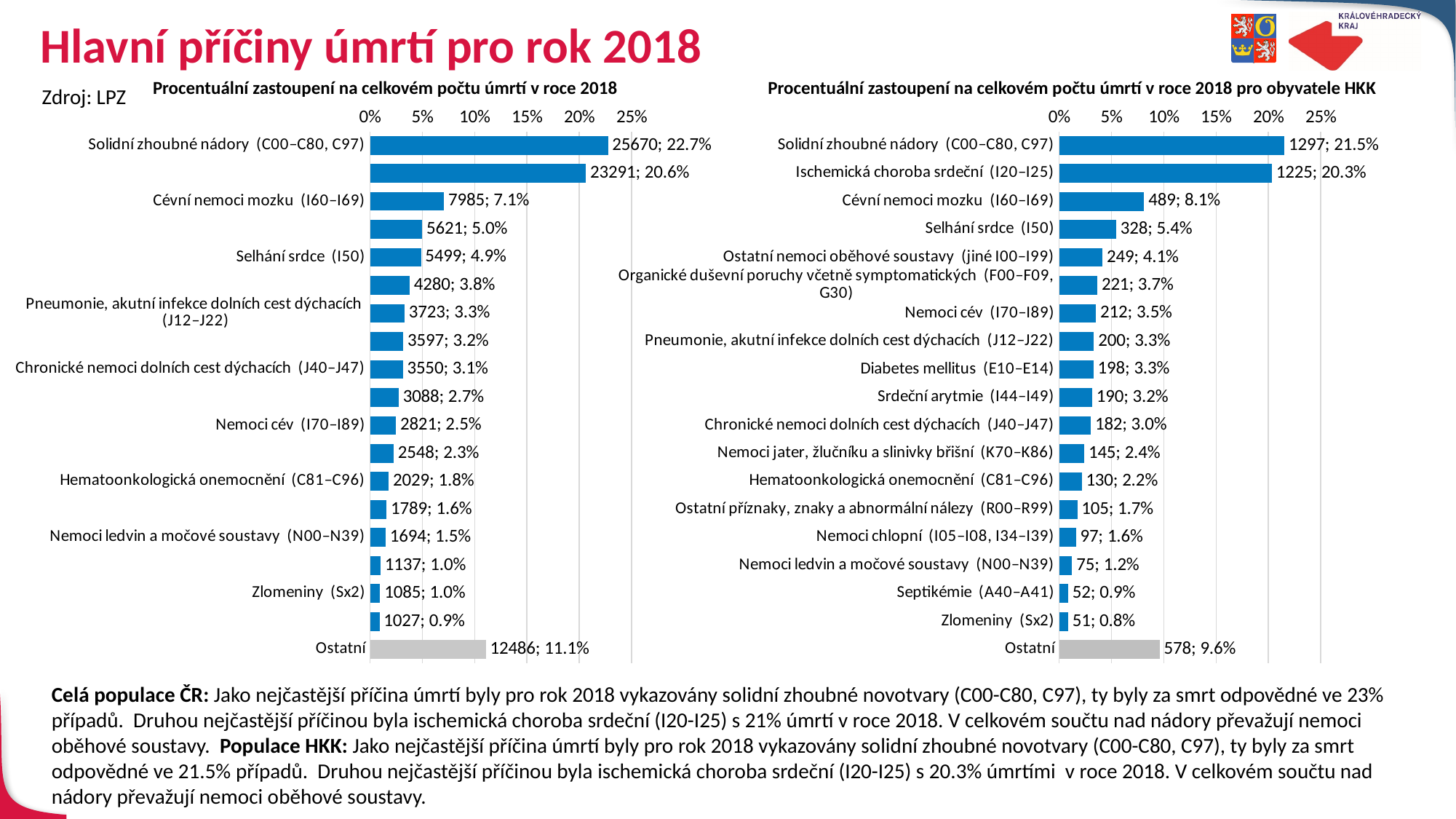
On the right chart, which named cause of death (excluding Ostatní) has the lowest value? Zlomeniny (Sx2) On the left chart, is the value for Cévní nemoci mozku (I60–I69) greater or less than 5%? greater What type of chart is used on the left side of the slide? Bar chart On the left chart, what percentage is shown for Cévní nemoci mozku (I60–I69)? 7.1% On the left chart, what is the difference in count between Cévní nemoci mozku (7985) and Selhání srdce (5499)? 2486 On the right chart, what is the data label for Diabetes mellitus (E10–E14)? 198; 3.3% How many bars are plotted on the right chart (including Ostatní)? 19 On the right chart, what is the difference in count between Solidní zhoubné nádory (1297) and Ischemická choroba srdeční (1225)? 72 On the left chart (Procentuální zastoupení na celkovém počtu úmrtí v roce 2018), what is the data label for Solidní zhoubné nádory (C00–C80, C97)? 25670; 22.7% On the right chart, which category has the highest value? Solidní zhoubné nádory (C00–C80, C97) On the right chart, which is larger: Cévní nemoci mozku (I60–I69) or Selhání srdce (I50)? Cévní nemoci mozku (I60–I69) On the right chart (pro obyvatele HKK), what is the data label for Ischemická choroba srdeční (I20–I25)? 1225; 20.3%